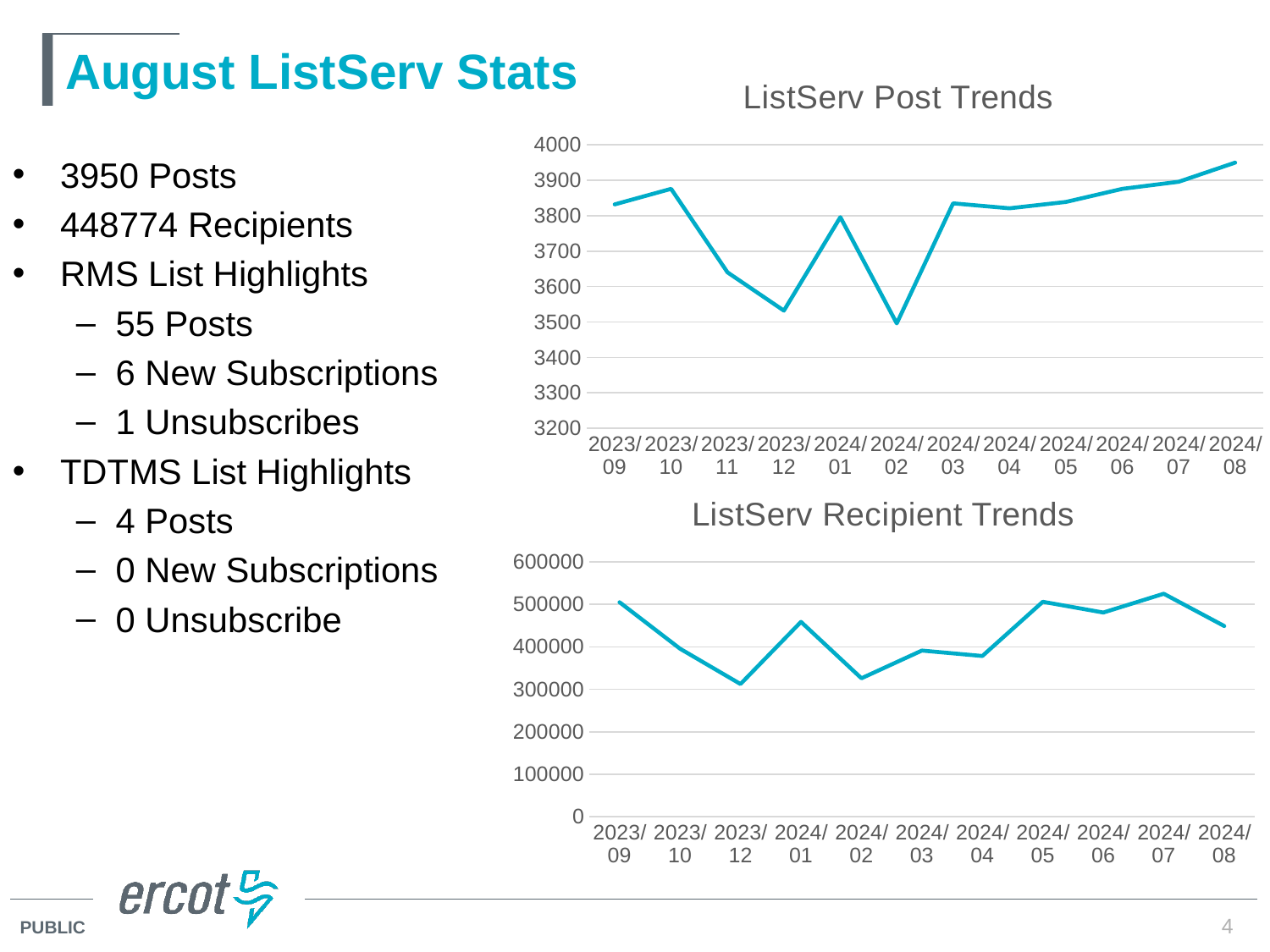
How many months are plotted on the ListServ Post Trends chart? 12 On the ListServ Post Trends chart, do the values rise or fall from 2024/03 to 2024/08? rise On the ListServ Post Trends chart, is the value for 2024/08 greater or less than 3900? greater On the ListServ Recipient Trends chart, which month has the highest value? 2024/07 On the ListServ Post Trends chart, is the value for 2024/02 greater or less than 3600? less On the ListServ Recipient Trends chart, which month has the lowest value? 2023/12 On the ListServ Post Trends chart, which month has the highest value? 2024/08 How many months are plotted on the ListServ Recipient Trends chart? 11 On the ListServ Recipient Trends chart, is the value for 2023/12 greater or less than 400000? less On the ListServ Post Trends chart, which is larger, the value for 2023/10 or the value for 2023/11? 2023/10 What kind of chart is the ListServ Post Trends chart? line chart